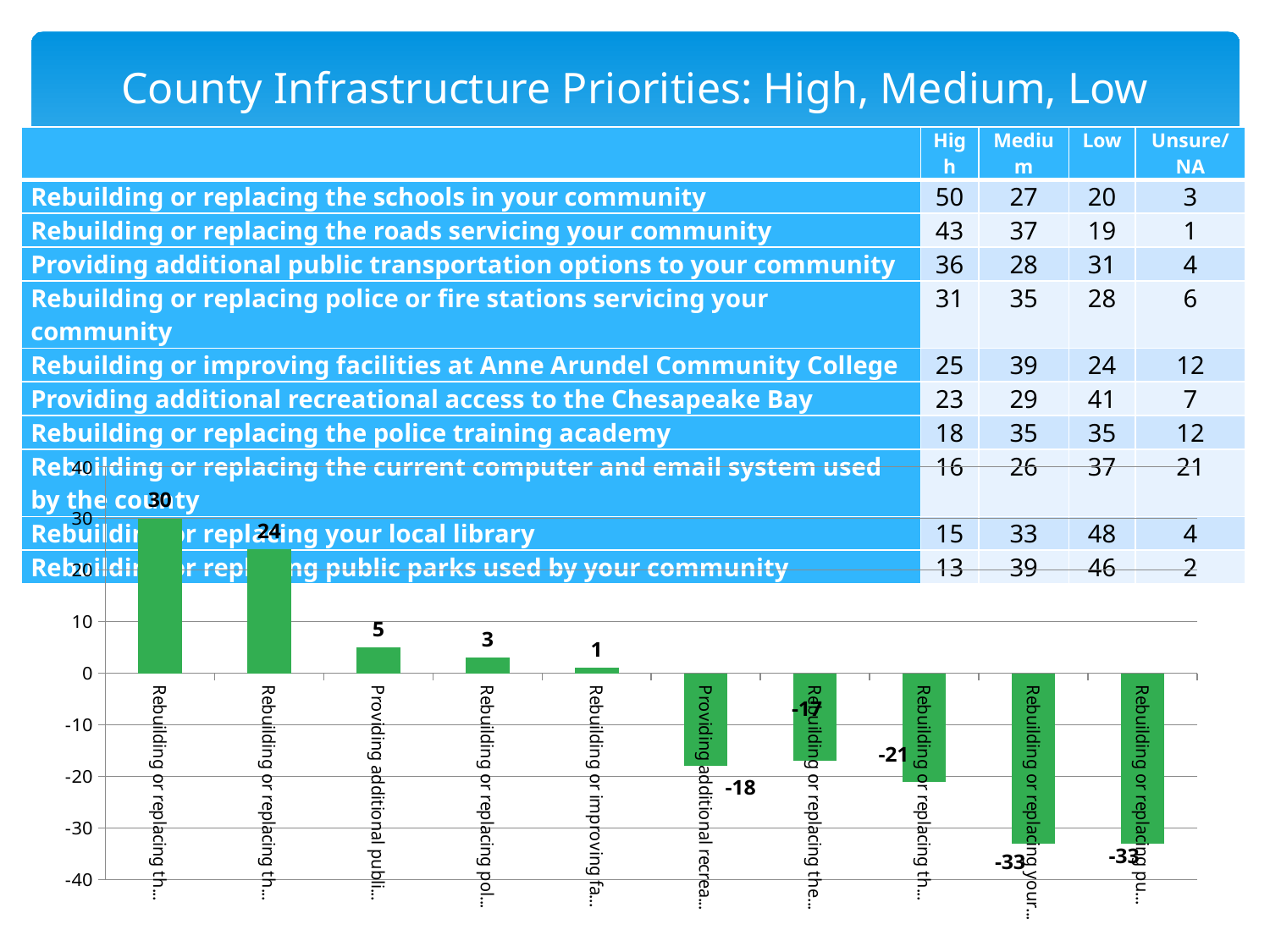
Which bar is larger: "Providing additional publi..." or "Rebuilding or replacing pol..."? Providing additional publi... How many bars does the chart show? 10 How many bars on the chart have a positive value? 5 What is the value of the bar labelled "Providing additional publi..."? 5 What is the value of the bar labelled "Rebuilding or improving fa..."? 1 What kind of chart is shown at the bottom of the slide? bar chart What is the highest value shown on the chart? 30 What is the value of the bar labelled "Providing additional recrea..."? -18 What is the value of the bar labelled "Rebuilding or replacing pol..."? 3 What is the lowest value shown on the chart? -33 What is the difference between the first bar (30) and the second bar (24)? 6 Do the bar values rise or fall from left to right across the chart? fall